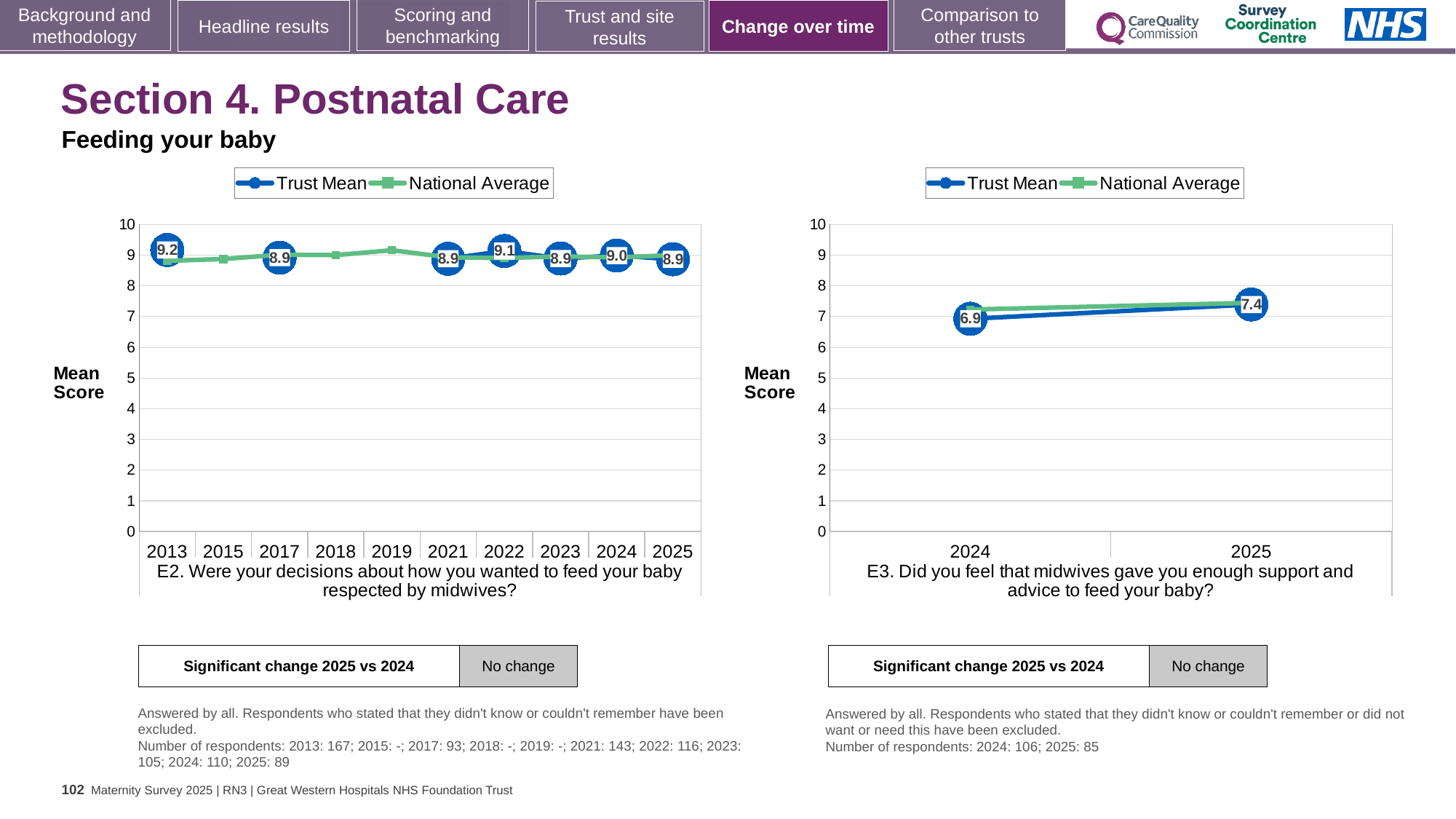
What kind of chart is the right chart (E3)? line chart In the left chart (E2), what is the Trust Mean value for 2013? 9.2 In the left chart (E2), is the National Average value for 2019 greater or less than 8? greater In the right chart (E3), what is the Trust Mean value for 2024? 6.9 In the right chart (E3), does the Trust Mean rise or fall from 2024 to 2025? rise In the left chart (E2), what is the difference between the Trust Mean values for 2013 and 2025? 0.3 In the left chart (E2), which is larger, the Trust Mean for 2022 or for 2024? 2022 In the left chart (E2), which year has the highest Trust Mean value? 2013 In the left chart (E2), how many series does the legend list? 2 In the left chart (E2), how many years are shown on the x axis? 10 In the left chart (E2), what is the Trust Mean value for 2025? 8.9 In the right chart (E3), what is the difference between the Trust Mean values for 2025 and 2024? 0.5